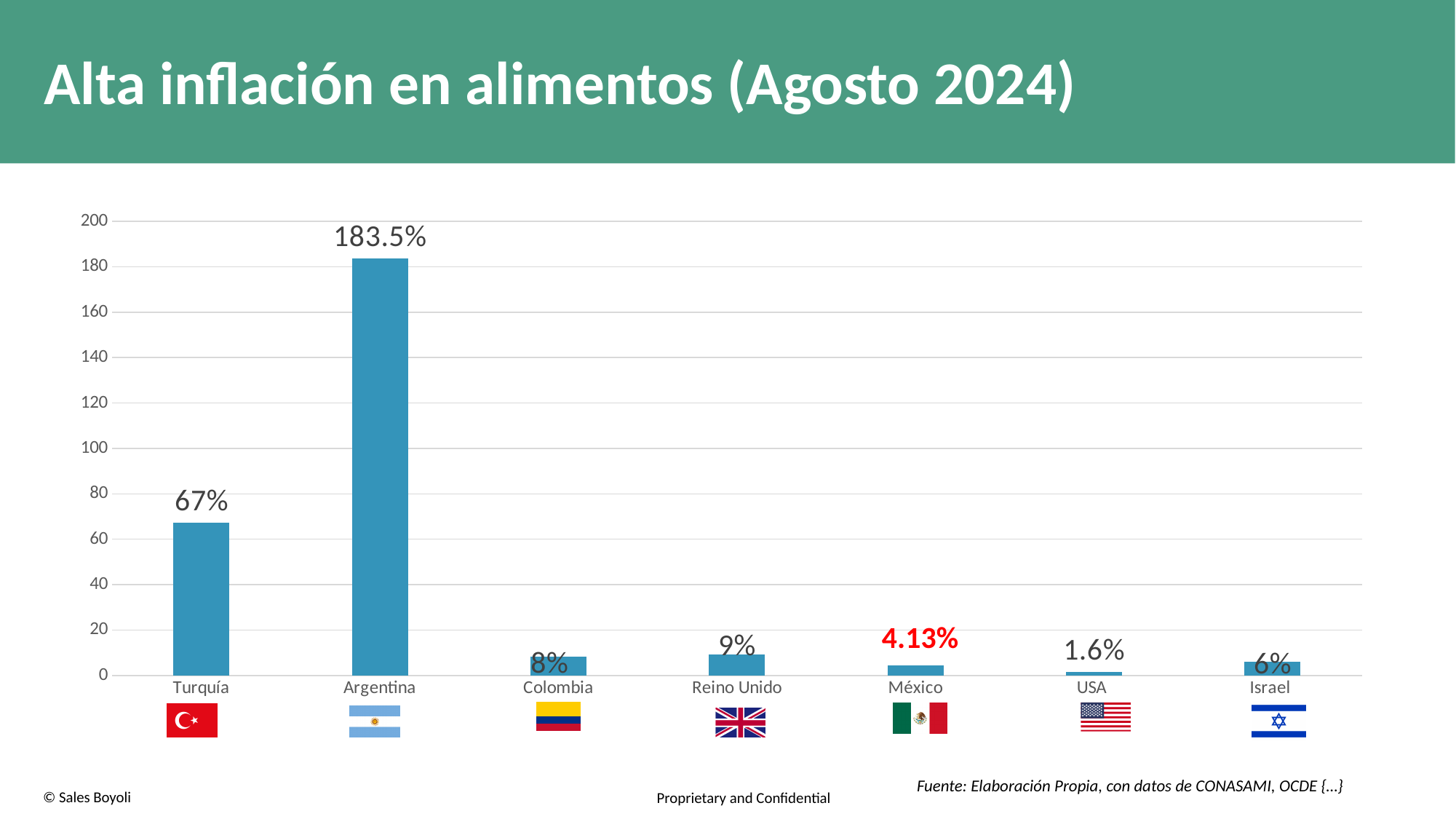
How many countries are shown on the chart? 7 Which country has the highest food inflation on the chart? Argentina What is the difference between the values for Argentina and Turquía? 116.5% What is the food inflation value shown for Argentina? 183.5% What is the value shown for México? 4.13% Which country has the lowest food inflation on the chart? USA Which country's data label is shown in red? México What is the value shown for Turquía? 67% Is the value for Turquía greater or less than 60? greater What is the value shown for USA? 1.6% Which has a higher value, Reino Unido or Colombia? Reino Unido What kind of chart is shown on the slide? Bar chart